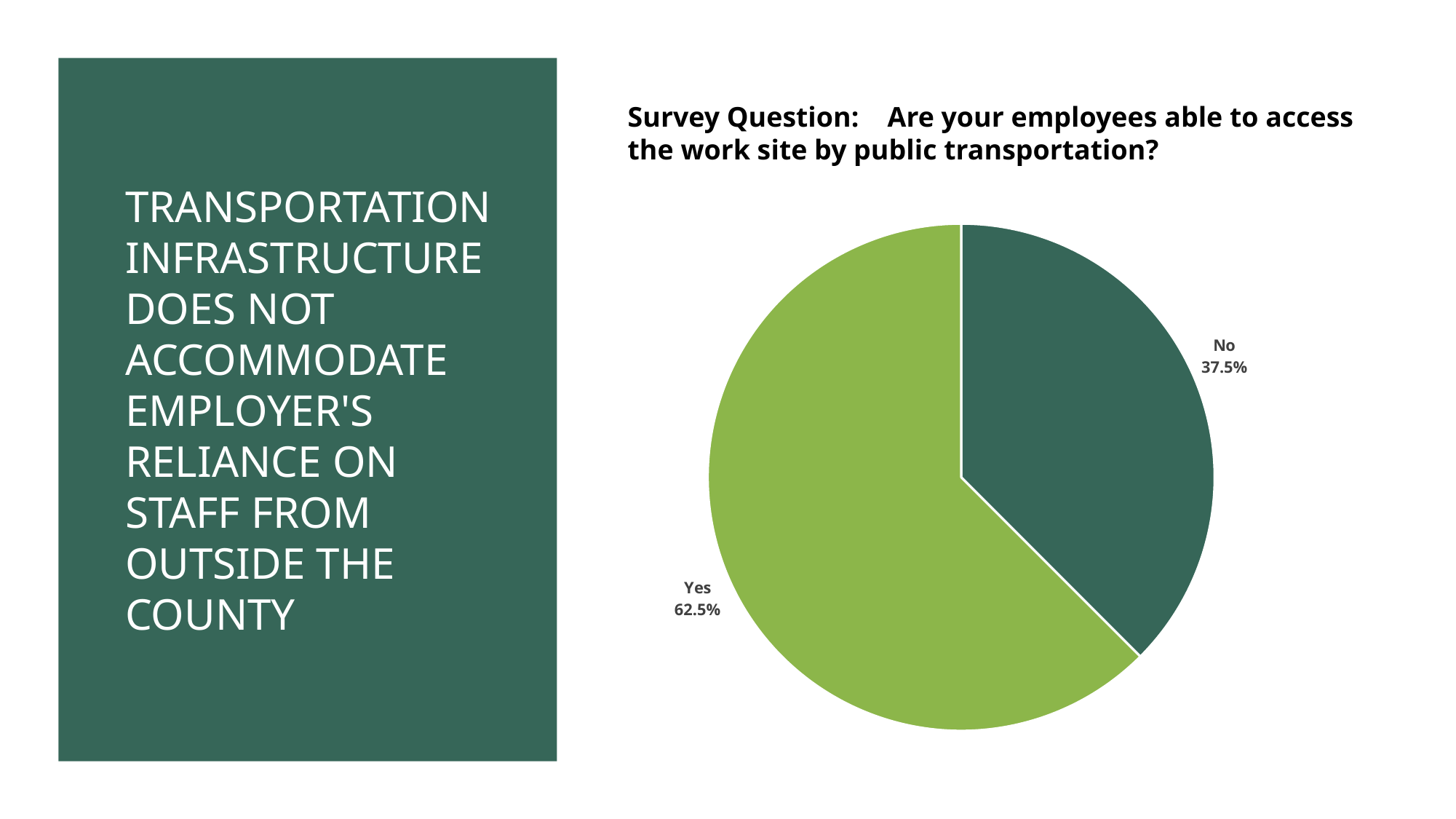
What survey question does the chart present? Are your employees able to access the work site by public transportation? Which response has the smallest share of the pie? No What is the difference in percentage points between the Yes and No shares? 25 Which response has the largest share of the pie? Yes What kind of chart is shown on the slide? Pie chart Which slice is shown in the darker green colour? No What percentage of respondents answered No? 37.5% What percentage of respondents answered Yes? 62.5% What share of the pie does the Yes slice represent? 62.5% How many slices does the pie chart have? 2 Which is larger, the Yes share or the No share? Yes